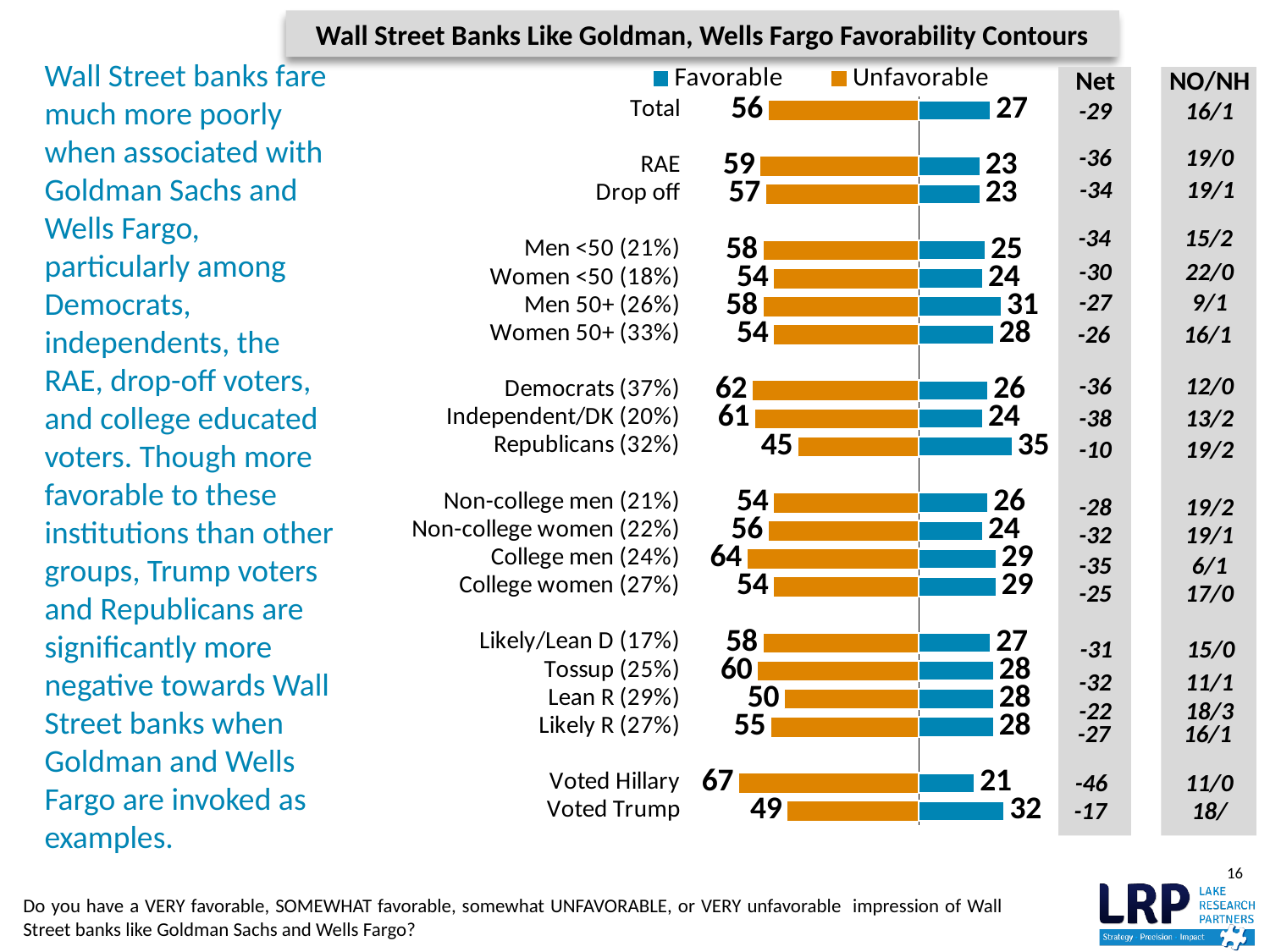
How many categories are plotted in the chart? 20 What is the Unfavorable value for Total? 56 How many series does the legend list? 2 What is the Favorable value for Men 50+ (26%)? 31 What is the Unfavorable value for Voted Hillary? 67 What kind of chart is shown on the slide? Bar chart What is the difference between the Unfavorable and Favorable values for Voted Trump? 17 Which category has the lowest Favorable value? Voted Hillary What is the Favorable value for Republicans (32%)? 35 Which is larger, the Unfavorable value for Democrats (37%) or for Independent/DK (20%)? Democrats (37%) Which category has the lowest Unfavorable value? Republicans (32%) Which category has the highest Unfavorable value? Voted Hillary